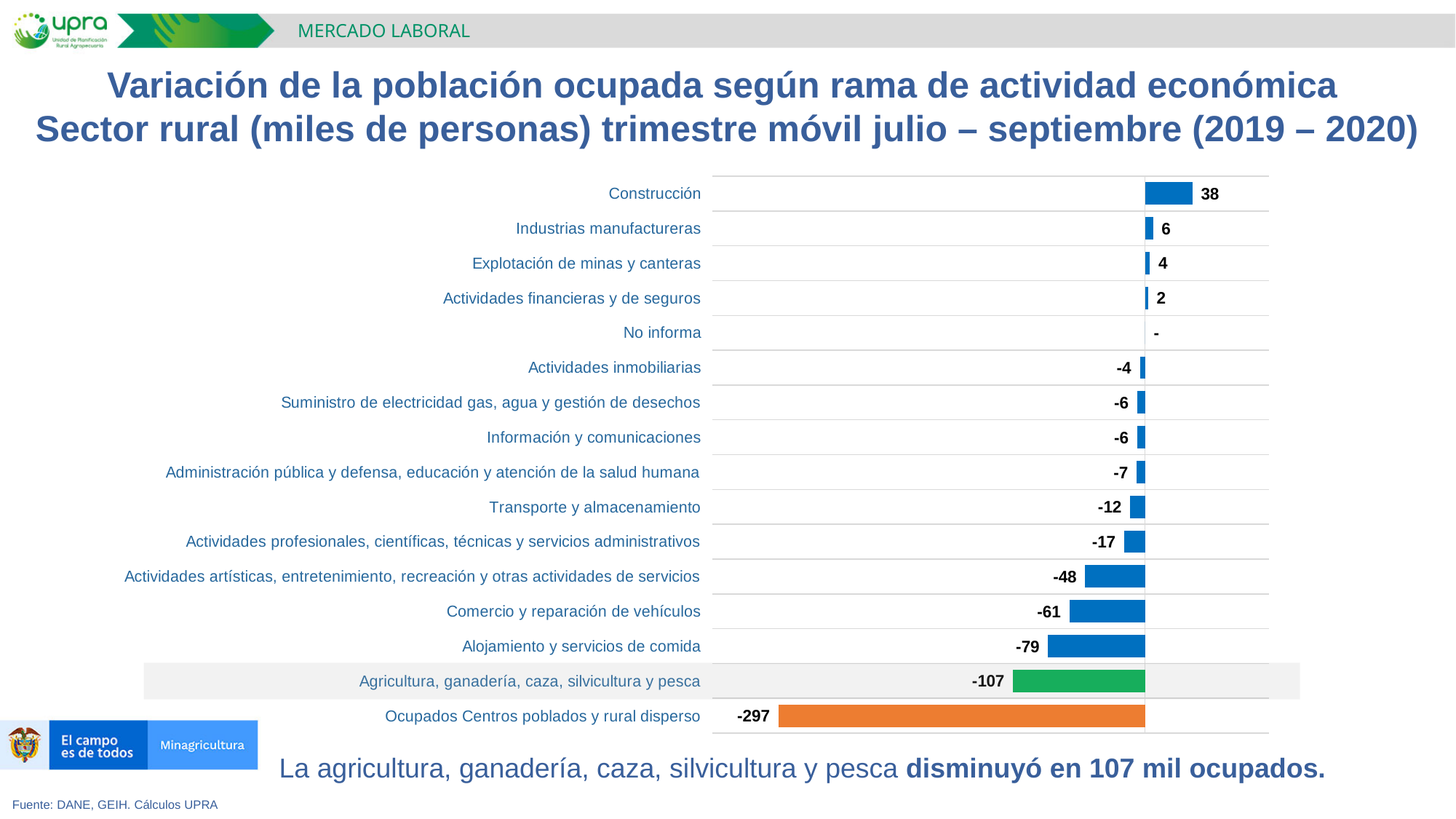
What is the value for Comercio y reparación de vehículos? -61 What is the value for Ocupados Centros poblados y rural disperso? -297 What colour is the bar for Agricultura, ganadería, caza, silvicultura y pesca? Green What is the value for Agricultura, ganadería, caza, silvicultura y pesca? -107 What is the difference between the values for Construcción and Industrias manufactureras? 32 What is the difference between the values for Alojamiento y servicios de comida and Agricultura, ganadería, caza, silvicultura y pesca? 28 Which category has the lowest value? Ocupados Centros poblados y rural disperso What is the value for Construcción? 38 How many categories are shown in the chart? 16 Which is larger, the value for Transporte y almacenamiento or the value for Actividades profesionales, científicas, técnicas y servicios administrativos? Transporte y almacenamiento What kind of chart is shown on the slide? Bar chart Which category has the highest value? Construcción